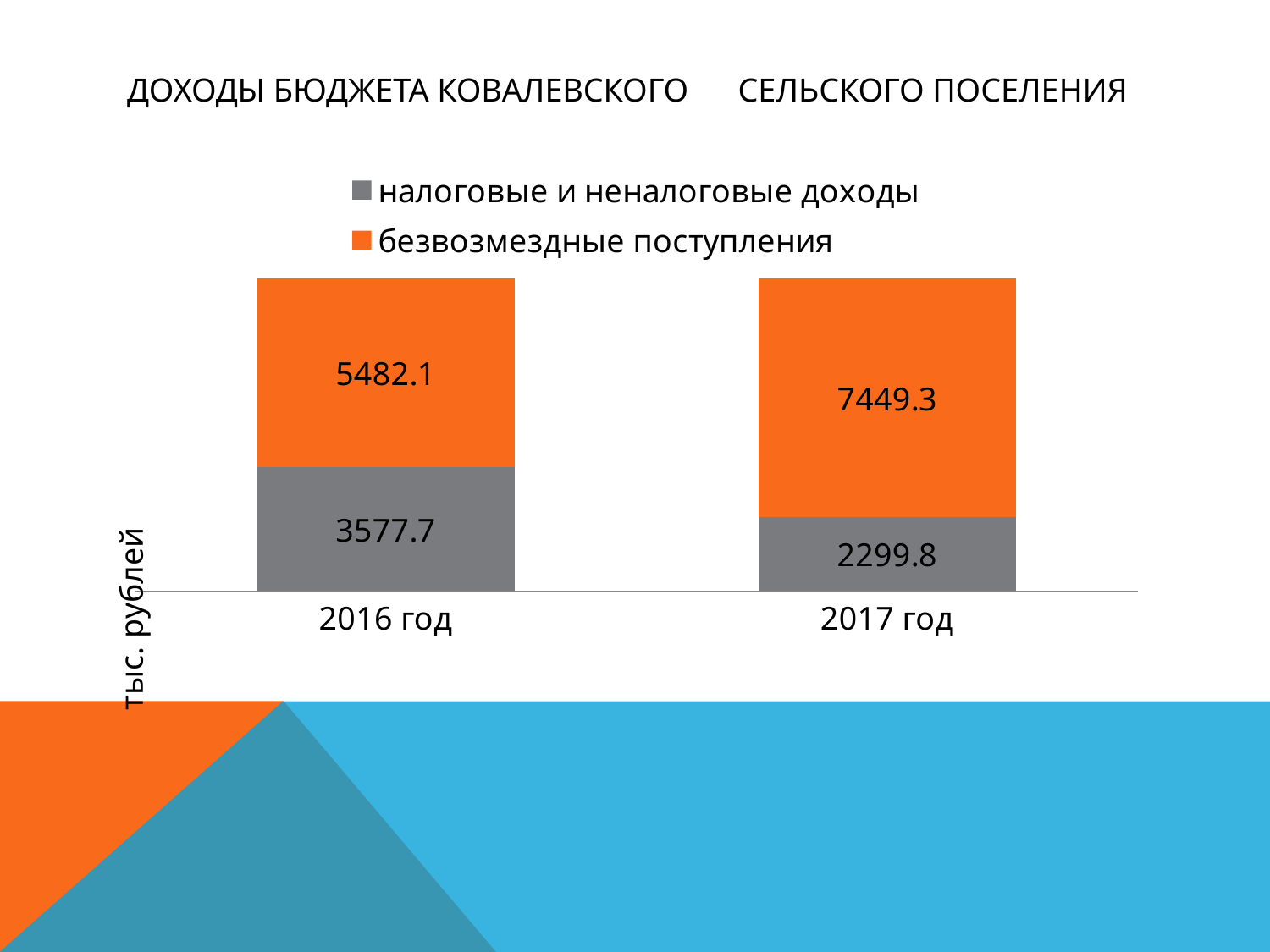
What type of chart is shown on the slide? stacked bar chart How many categories are shown on the x axis? 2 What is the difference between безвозмездные поступления in 2017 год and in 2016 год? 1967.2 What is the total of the stacked bar for 2016 год? 9059.8 What is the value of налоговые и неналоговые доходы for 2016 год? 3577.7 Which colour represents безвозмездные поступления in the chart? orange What is the value of налоговые и неналоговые доходы for 2017 год? 2299.8 What is the value of безвозмездные поступления for 2017 год? 7449.3 How many series does the legend list? 2 Which is larger: налоговые и неналоговые доходы in 2016 год or in 2017 год? 2016 год What is the total of the stacked bar for 2017 год? 9749.1 What is the value of безвозмездные поступления for 2016 год? 5482.1